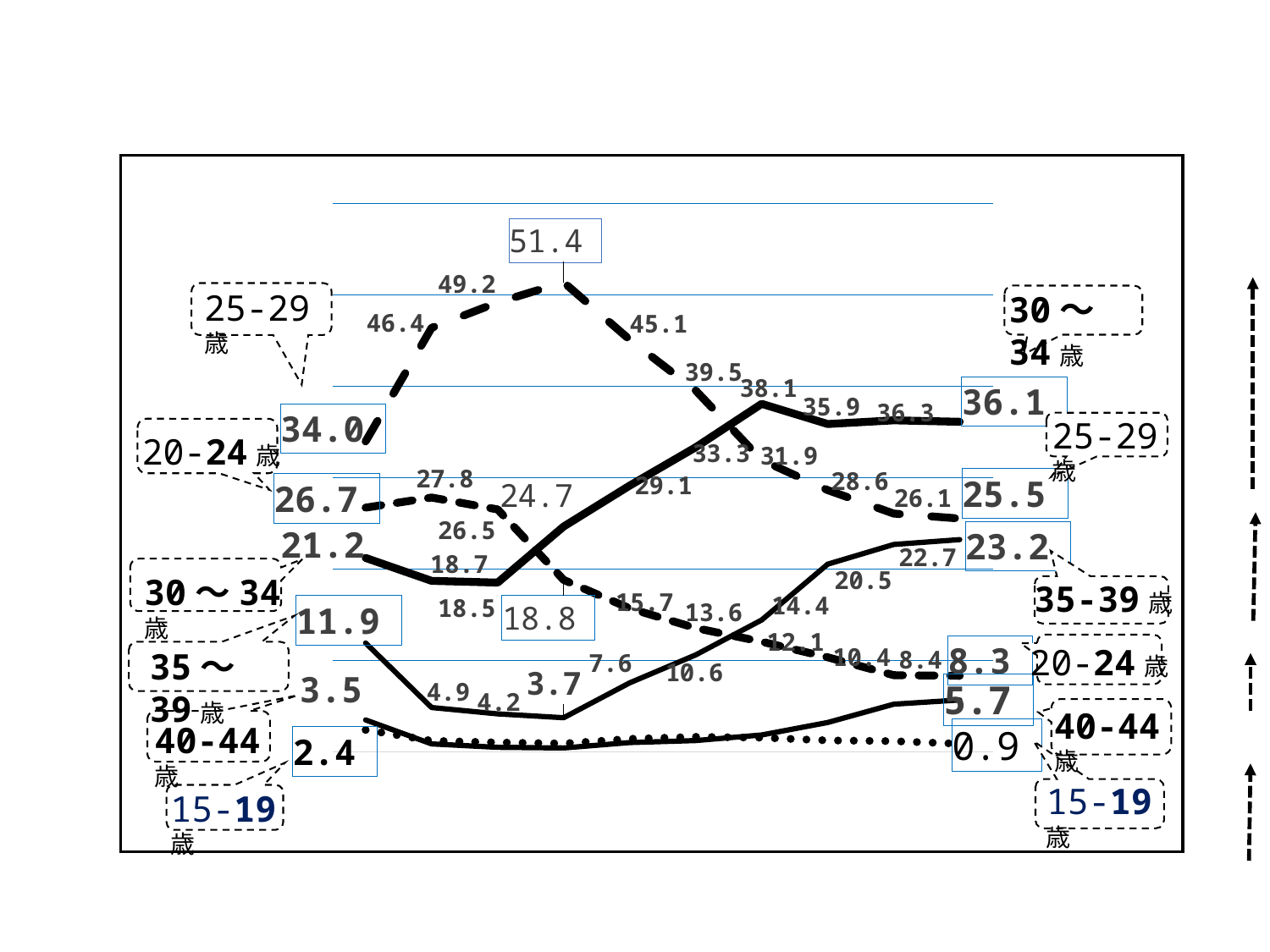
What is the first (leftmost) value of the 25-29歳 series? 34.0 Does the 20-24歳 series rise or fall from its first value (26.7) to its last value (8.3)? fall What is the highest value reached by the 25-29歳 series? 51.4 What kind of chart is shown on the slide? line chart Which age-group series has the lowest value at the right end of the chart? 15-19歳 What is the last (rightmost) value of the 15-19歳 series? 0.9 What is the difference between the first value (34.0) and the last value (25.5) of the 25-29歳 series? 8.5 What is the last (rightmost) value of the 30～34歳 series? 36.1 How many age-group series are plotted on the chart? 6 At the right end of the chart, which is larger: the 35-39歳 value or the 20-24歳 value? 35-39歳 What is the difference between the last value (36.1) and the first value (21.2) of the 30～34歳 series? 14.9 Which age-group series has the highest value at the right end of the chart? 30～34歳